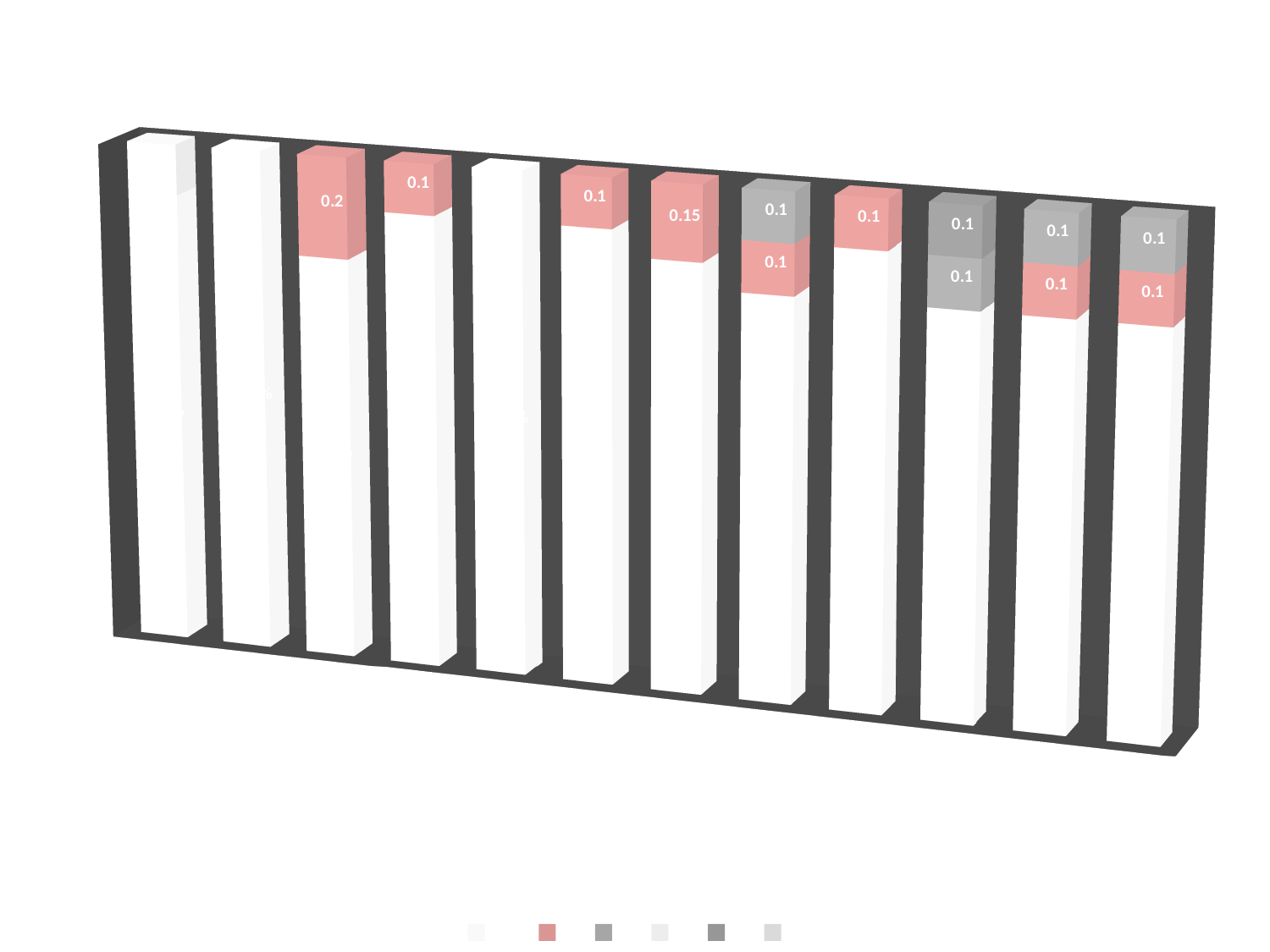
How many bars have a grey segment stacked on top? 4 What kind of chart is shown on the slide? Stacked bar chart What value is labelled on the pink segment of the third bar from the left? 0.2 What colour is the topmost segment of the eighth bar from the left? Grey How many entries does the legend at the bottom of the chart show? 6 What is the difference between the pink segment of the third bar from the left and the pink segment of the fourth bar from the left? 0.1 What is the difference between the pink segment of the third bar from the left (0.2) and the pink segment of the seventh bar from the left (0.15)? 0.05 How many bars are plotted in the chart? 12 Is the pink segment of the third bar from the left larger or smaller than the pink segment of the fourth bar from the left? Larger What value is labelled on the pink segment of the fourth bar from the left? 0.1 What value is labelled on the pink segment of the seventh bar from the left? 0.15 Which bar has the largest labelled pink segment? The third bar from the left